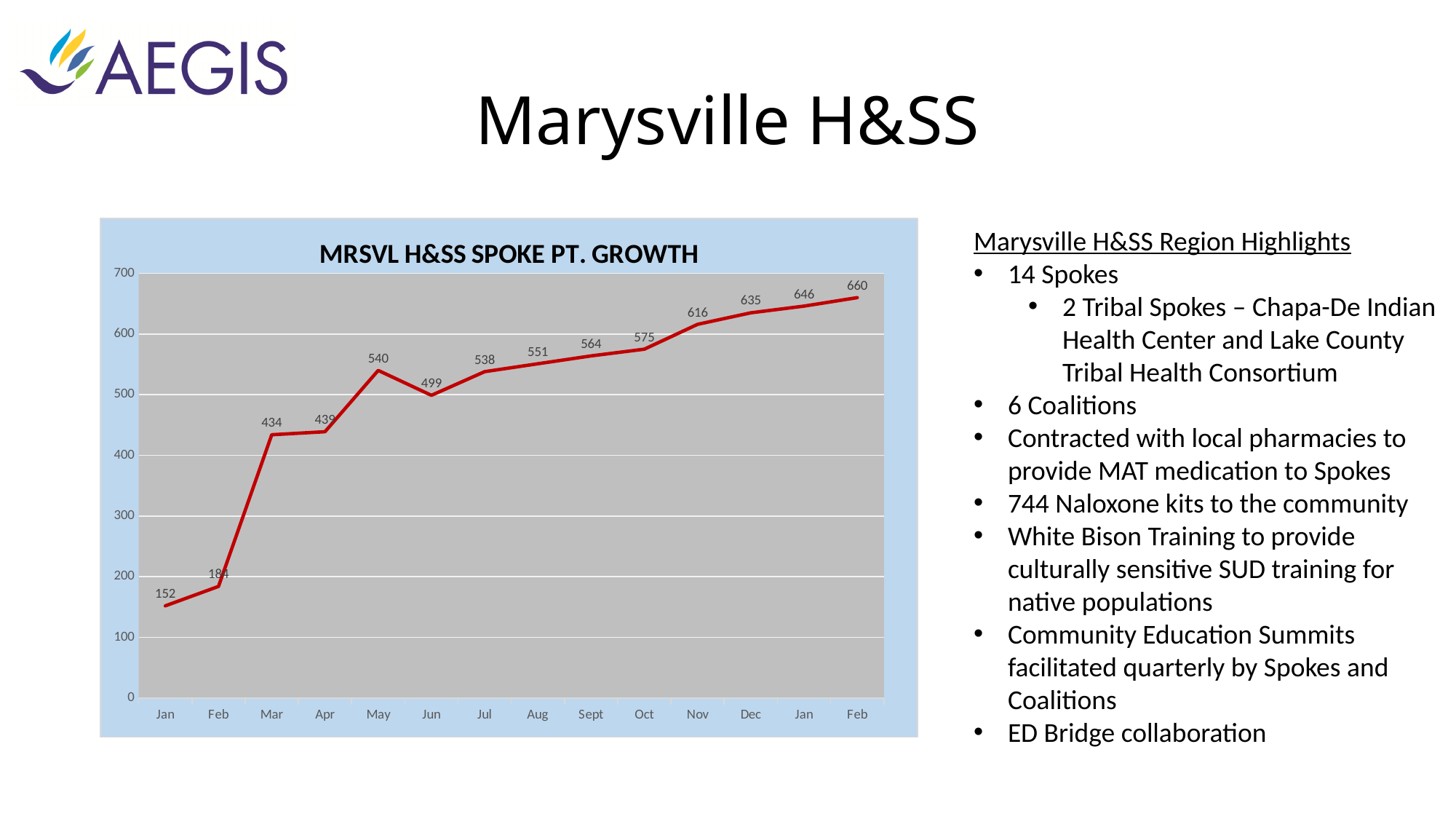
What is the title of the chart? MRSVL H&SS SPOKE PT. GROWTH What kind of chart is shown on the slide? line chart Which is larger, the value for May or the value for Jul? May What is the value plotted for Nov? 616 What is the lowest value plotted on the chart? 152 How many data points are plotted on the chart? 14 What is the highest value plotted on the chart? 660 By how much does the value drop from May to Jun? 41 What is the value plotted for May? 540 Do the values generally rise or fall from left to right along the x axis? rise What is the difference between the values for Apr and Mar? 5 What is the value plotted for Oct? 575